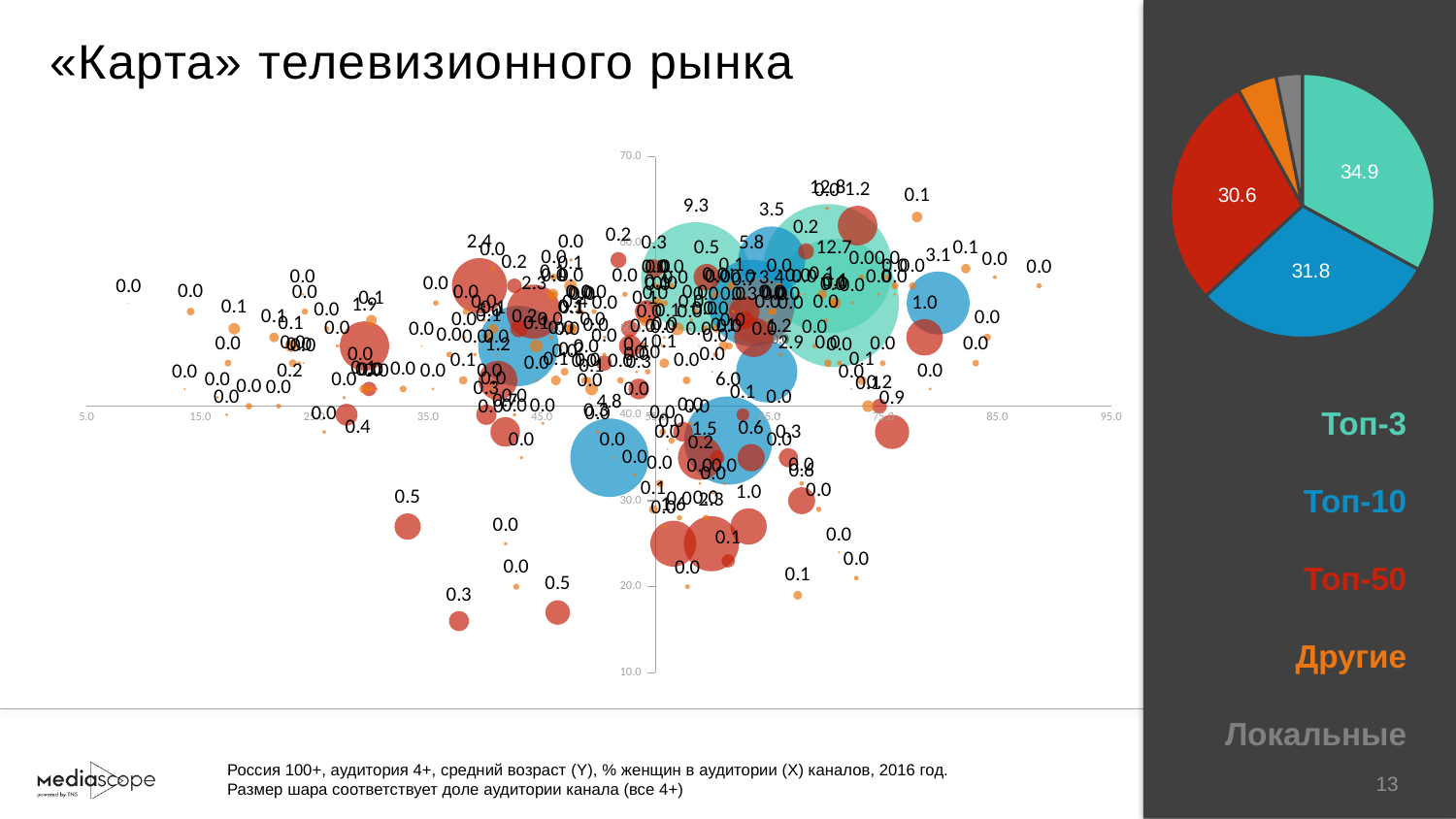
What kind of chart is shown on the right side of the slide? Pie chart On the pie chart, which is larger: the Топ-10 slice or the Топ-50 slice? Топ-10 On the pie chart, which group has the largest slice? Топ-3 On the pie chart, what is the difference between the Топ-10 value and the Топ-50 value? 1.2 On the pie chart, what is the difference between the Топ-3 value and the Топ-10 value? 3.1 What kind of chart is shown on the left side of the slide? Bubble chart On the bubble chart, what is the highest value shown on the vertical axis? 70.0 On the pie chart, which colour represents the Топ-50 group? Red On the pie chart, what value is shown for the Топ-10 slice? 31.8 On the pie chart, what value is shown for the Топ-3 slice? 34.9 On the pie chart, what value is shown for the Топ-50 slice? 30.6 How many slices does the pie chart have? 5